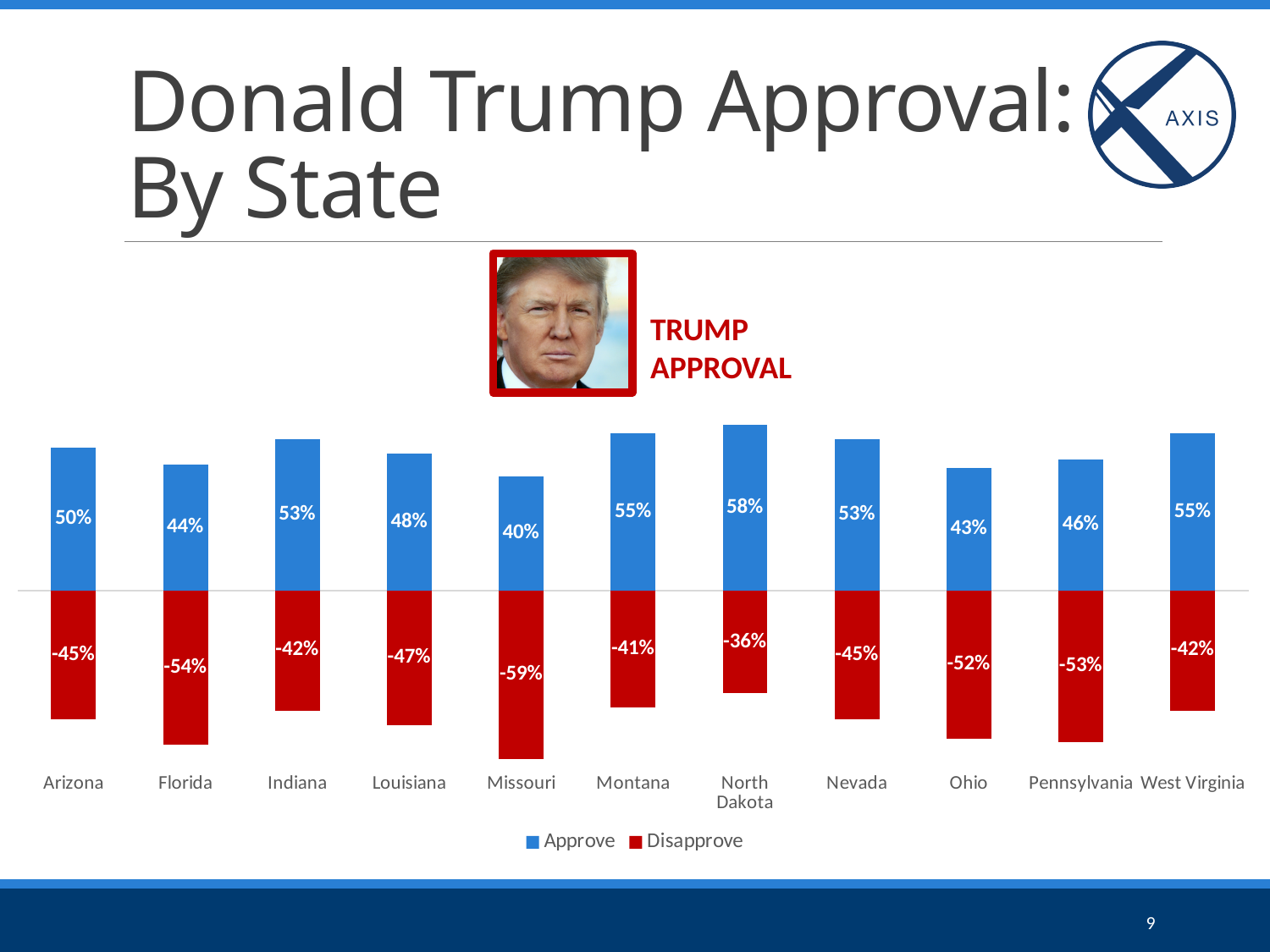
What is the Approve value for Pennsylvania? 46% How many states are shown on the chart? 11 What is the difference between the Approve values for Montana and Ohio? 12% What is the Approve value for North Dakota? 58% How many series does the legend list? 2 Which state has the highest Approve value? North Dakota What is the Disapprove value for Missouri? -59% Which state has the lowest Approve value? Missouri What is the Disapprove value for West Virginia? -42% What kind of chart is shown on the slide? Bar chart Which state has a higher Approve value, Arizona or Florida? Arizona Which colour represents the Disapprove series in the legend? Red